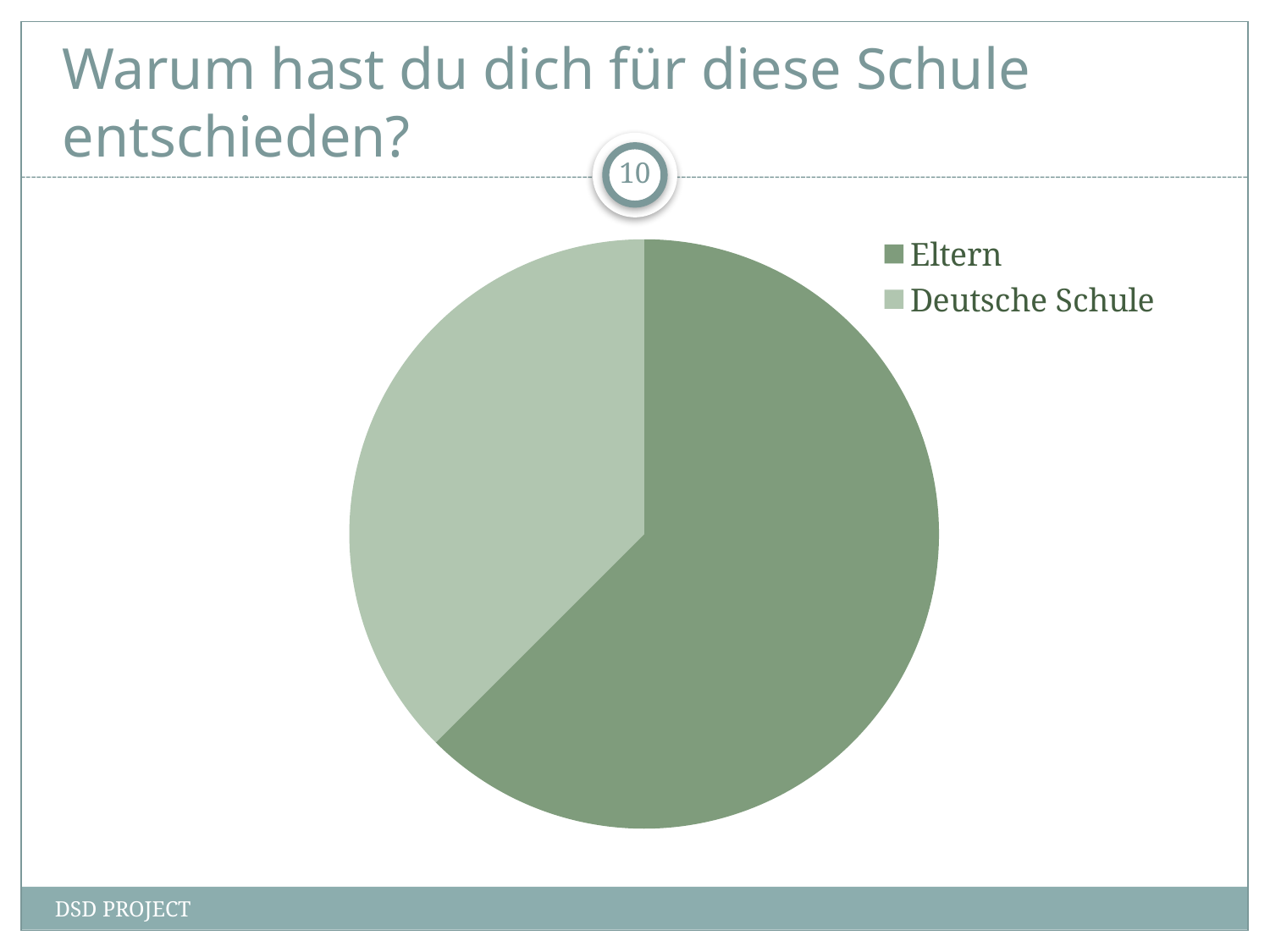
What kind of chart is shown on the slide? Pie chart How many slices does the pie chart have? 2 Which slice is larger, Eltern or Deutsche Schule? Eltern Which category has the smallest slice of the pie chart? Deutsche Schule How many entries does the legend of the pie chart list? 2 Which category is shown in the lighter green colour in the pie chart? Deutsche Schule Which category has the largest slice of the pie chart? Eltern Does the Eltern slice take up more or less than half of the pie? More What are the two categories listed in the legend of the pie chart? Eltern and Deutsche Schule